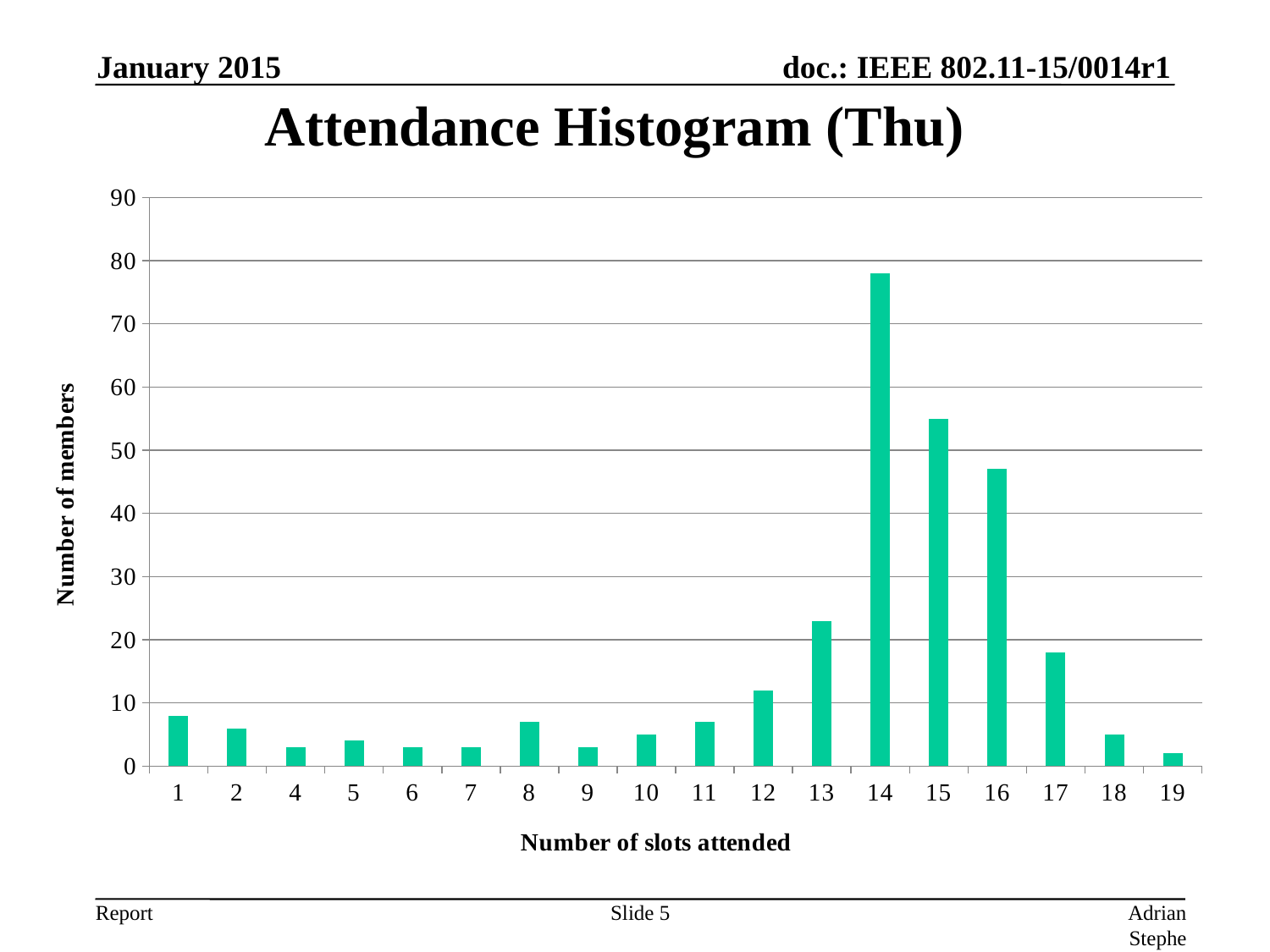
What type of chart is shown on the slide? bar chart Is the value for 15 slots attended greater or less than 50? greater Is the value for 13 slots attended greater or less than 20? greater Which has more members: 14 slots attended or 15 slots attended? 14 Which number of slots attended has the highest number of members? 14 How many categories (number of slots attended) are shown on the x axis? 18 Which has more members: 13 slots attended or 17 slots attended? 13 Is the value for 17 slots attended greater or less than 20? less What is the label of the vertical axis? Number of members What is the title of the chart? Attendance Histogram (Thu)